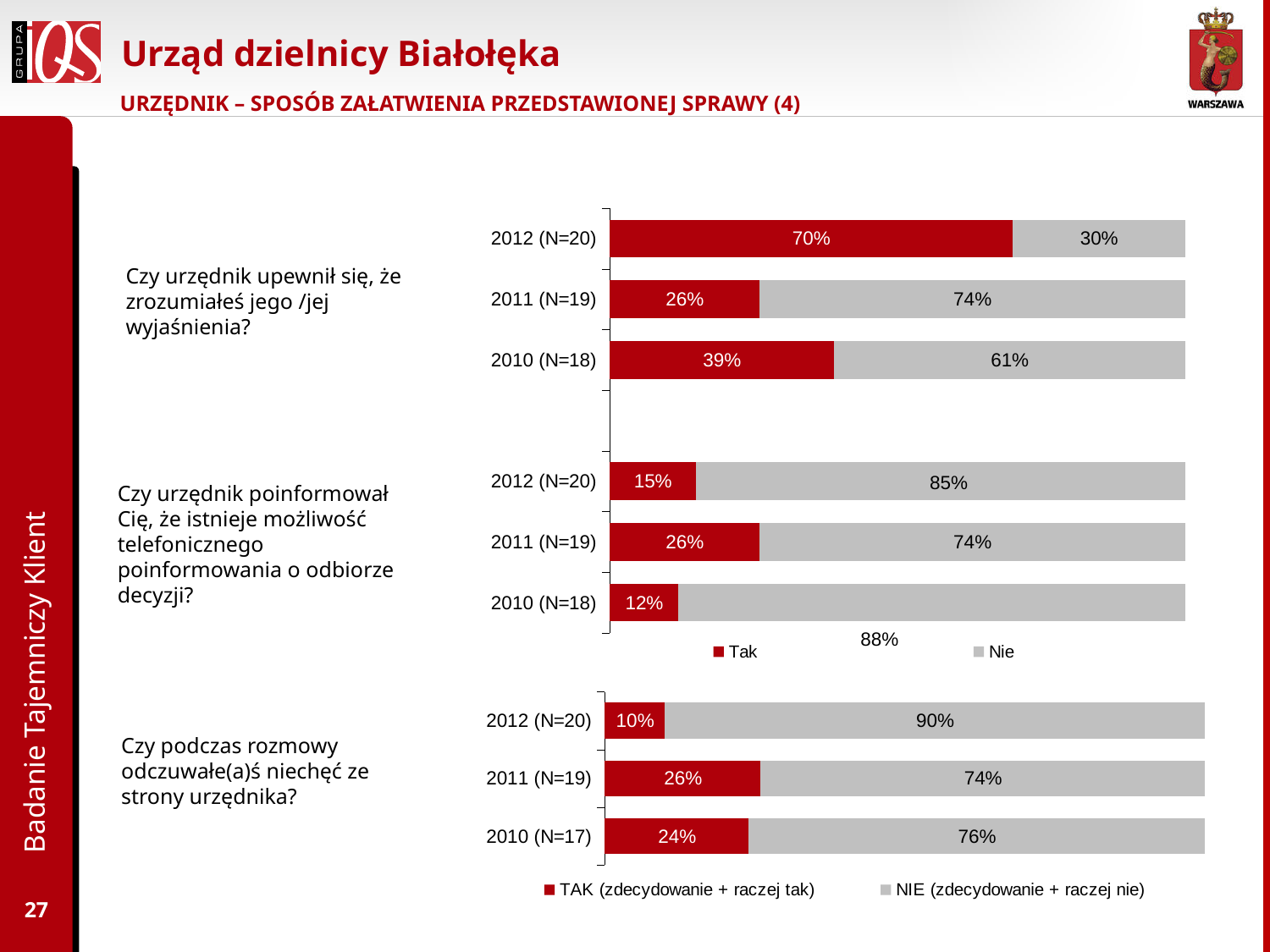
In the chart for the question "Czy urzędnik upewnił się, że zrozumiałeś jego /jej wyjaśnienia?", what is the difference between the Tak values for 2012 (N=20) and 2011 (N=19)? 44 percentage points In the chart for the question "Czy urzędnik poinformował Cię, że istnieje możliwość telefonicznego poinformowania o odbiorze decyzji?", is the Tak value for 2011 (N=19) larger or smaller than the Tak value for 2012 (N=20)? larger In the bottom chart for the question "Czy podczas rozmowy odczuwałe(a)ś niechęć ze strony urzędnika?", what is the NIE value for 2010 (N=17)? 76% What type of chart is used on this slide? Stacked bar chart In the chart for the question "Czy urzędnik upewnił się, że zrozumiałeś jego /jej wyjaśnienia?", which year has the highest Tak value? 2012 (N=20) In the bottom chart for the question "Czy podczas rozmowy odczuwałe(a)ś niechęć ze strony urzędnika?", what is the total of the two segments for 2011 (N=19)? 100% In the chart for the question "Czy urzędnik poinformował Cię, że istnieje możliwość telefonicznego poinformowania o odbiorze decyzji?", which year has the lowest Tak value? 2010 (N=18) In the chart for the question "Czy urzędnik poinformował Cię, że istnieje możliwość telefonicznego poinformowania o odbiorze decyzji?", what is the Nie value for 2012 (N=20)? 85% In the bottom chart for the question "Czy podczas rozmowy odczuwałe(a)ś niechęć ze strony urzędnika?", what is the TAK value for 2012 (N=20)? 10% In the chart for the question "Czy urzędnik upewnił się, że zrozumiałeś jego /jej wyjaśnienia?", what is the Tak value for 2012 (N=20)? 70% In the chart for the question "Czy urzędnik upewnił się, że zrozumiałeś jego /jej wyjaśnienia?", what is the Nie value for 2010 (N=18)? 61% How many series does the legend of the bottom chart list? 2